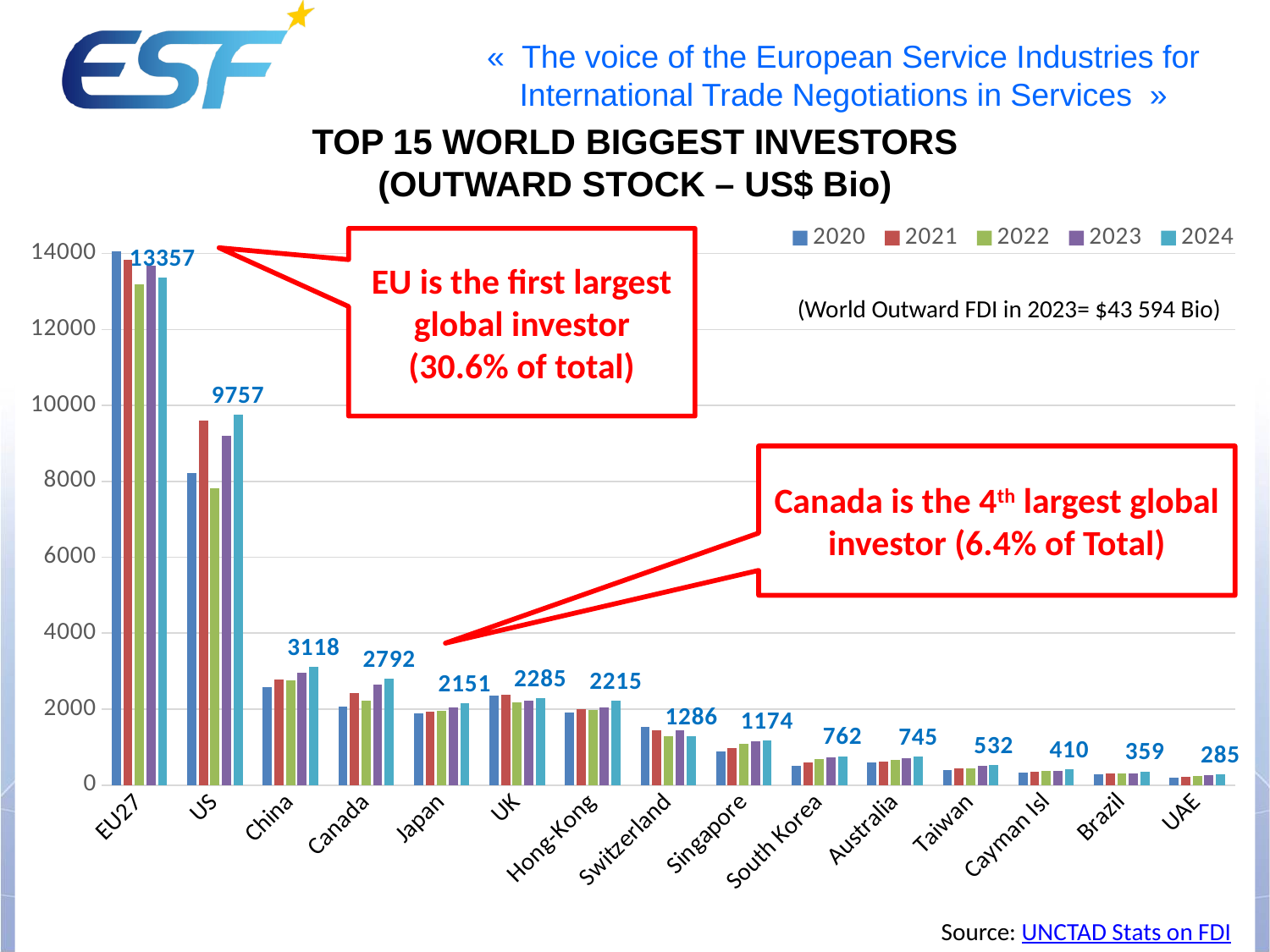
Is the 2022 value for EU27 greater or less than 12000? greater What value is labelled above the bars for Singapore? 1174 Which has the larger labelled value, the UK or Hong-Kong? UK What kind of chart is shown on the slide? Bar chart What value is labelled above the bars for Canada? 2792 Which country has the lowest labelled value on the chart? UAE How many countries or economies are shown on the x axis? 15 Which country has the highest labelled value on the chart? EU27 How many series does the legend list? 5 What is the difference between the labelled values for China and Canada? 326 What value is labelled above the bars for the UK? 2285 Which years are listed in the chart legend? 2020, 2021, 2022, 2023, 2024